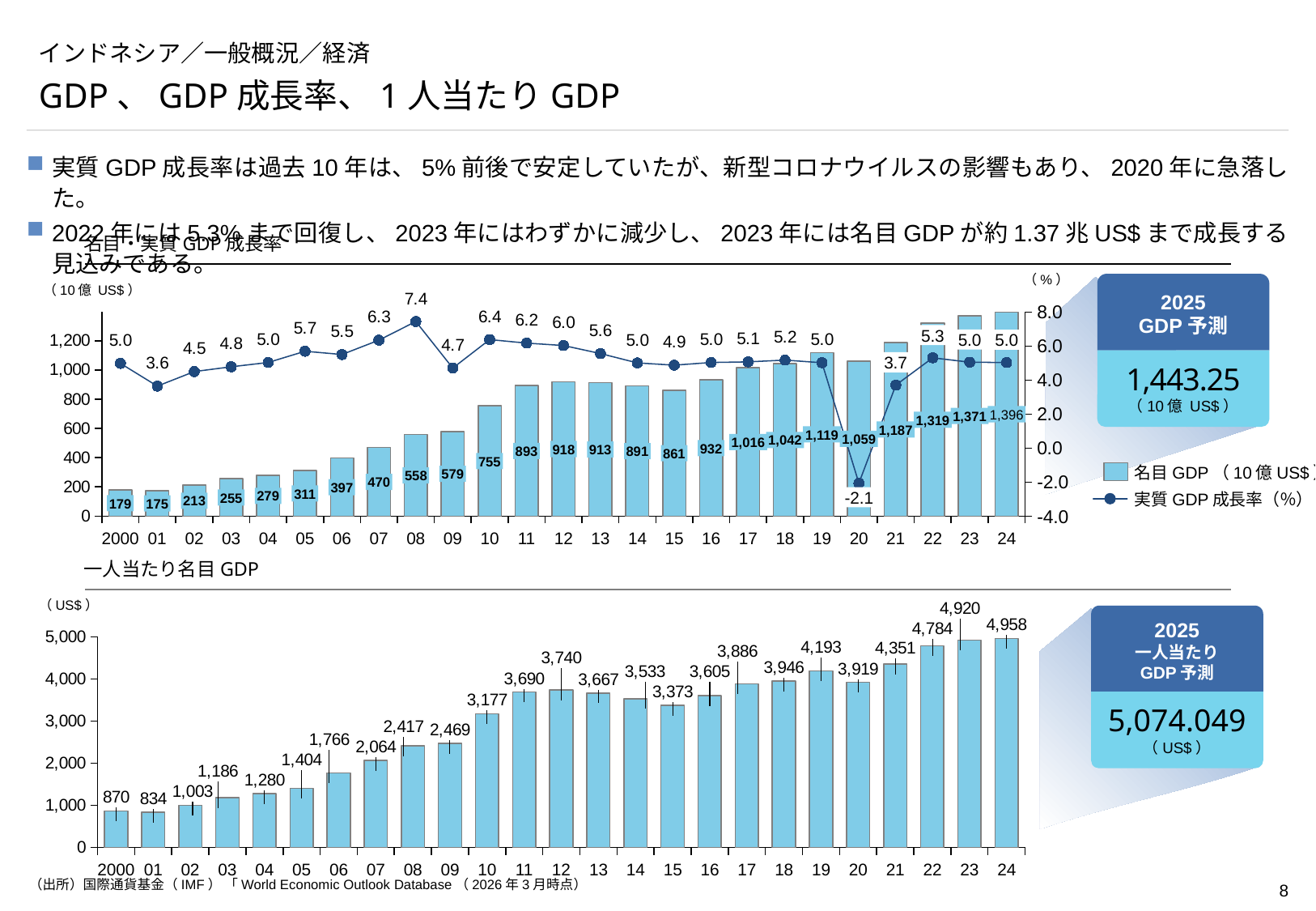
下のグラフ「一人当たり名目GDP」は、どの種類のグラフですか？ 棒グラフ 上のグラフ「名目・実質GDP成長率」で、2023年の名目GDPの値はいくらですか？ 1,371 上のグラフ「名目・実質GDP成長率」で、実質GDP成長率が最も高い年はどれですか？ 2008年 下のグラフ「一人当たり名目GDP」で、2019年と2020年ではどちらの値が大きいですか？ 2019年 下のグラフ「一人当たり名目GDP」で、最も値が低い年はどれですか？ 2001年 上のグラフ「名目・実質GDP成長率」で、実質GDP成長率が最も低い年はどれですか？ 2020年 上のグラフ「名目・実質GDP成長率」で、2024年と2000年の名目GDPの差はいくらですか？ 1,217 下のグラフ「一人当たり名目GDP」で、2025年の一人当たりGDP予測値はいくらですか？ 5,074.049（US$） 下のグラフ「一人当たり名目GDP」で、2022年の値はいくらですか？ 4,784 上のグラフ「名目・実質GDP成長率」の凡例には、いくつの系列が示されていますか？ 2 上のグラフ「名目・実質GDP成長率」で、2020年の実質GDP成長率はいくらですか？ -2.1 上のグラフ「名目・実質GDP成長率」で、2025年のGDP予測値はいくらですか？ 1,443.25（10億US$）